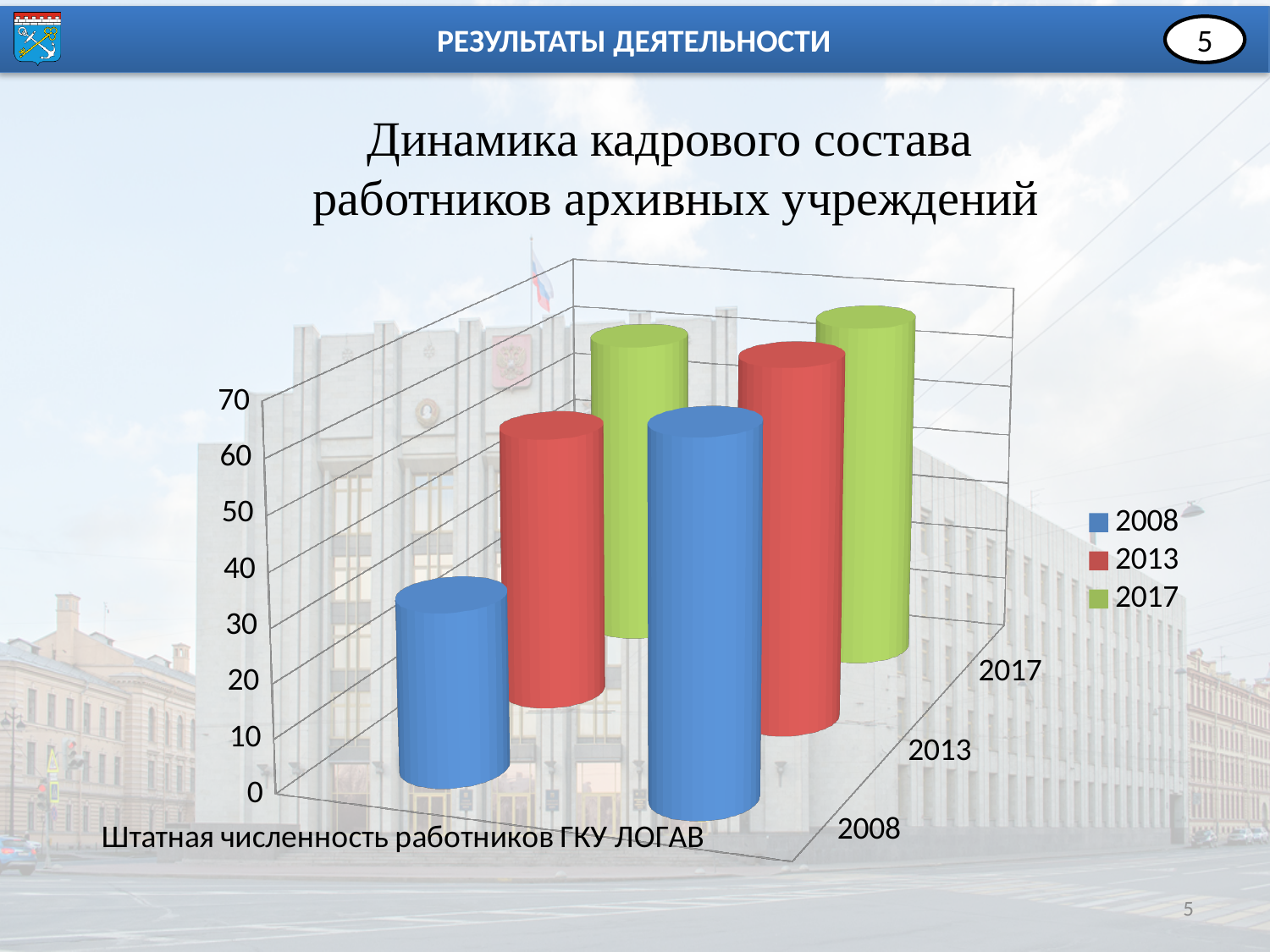
For the category 'Штатная численность работников ГКУ ЛОГАВ', which year has the lowest value? 2008 For the category 'Штатная численность работников ГКУ ЛОГАВ', which is larger: the value for 2008 or the value for 2017? 2017 Which colour represents the 2017 series in the chart? green Is the value for 2008 in the category 'Штатная численность работников ГКУ ЛОГАВ' greater or less than 50? less Which years are listed in the chart legend? 2008, 2013, 2017 What is the title shown above the chart? Динамика кадрового состава работников архивных учреждений What kind of chart is shown on the slide? bar chart For the category 'Штатная численность работников ГКУ ЛОГАВ', which is larger: the value for 2008 or the value for 2013? 2013 How many series does the chart legend list? 3